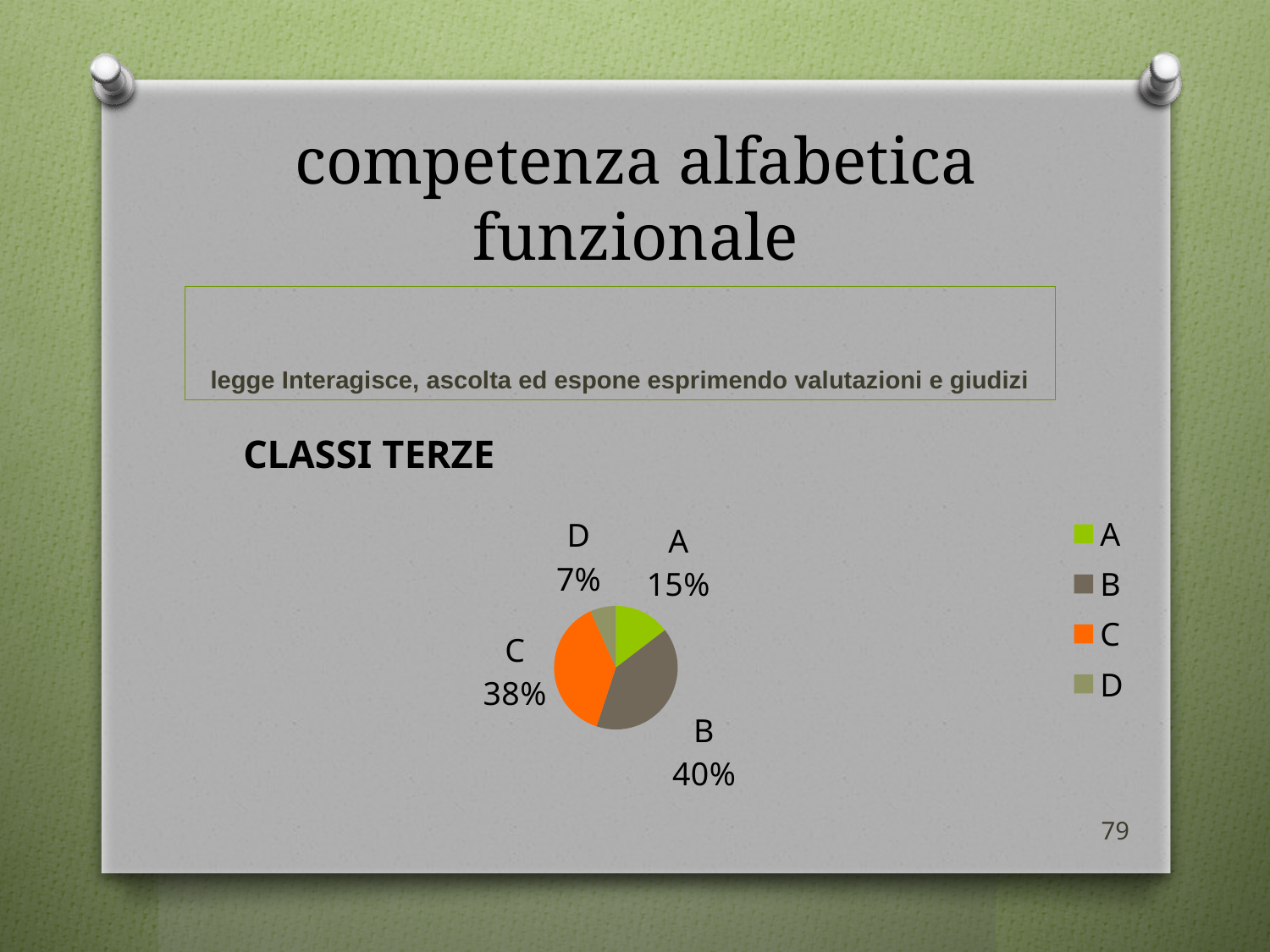
Which slice has the smallest share? D What is the value for slice A? 15% What colour is slice C in the legend? orange What is the value for slice D? 7% What is the value for slice C? 38% How many slices does the pie chart have? 4 What is the difference between the values for B and C? 2% What kind of chart is shown on the slide? pie chart What is the value for slice B? 40% What is the difference between the values for A and D? 8% Which slice has the largest share? B Which is larger, the value for A or the value for D? A